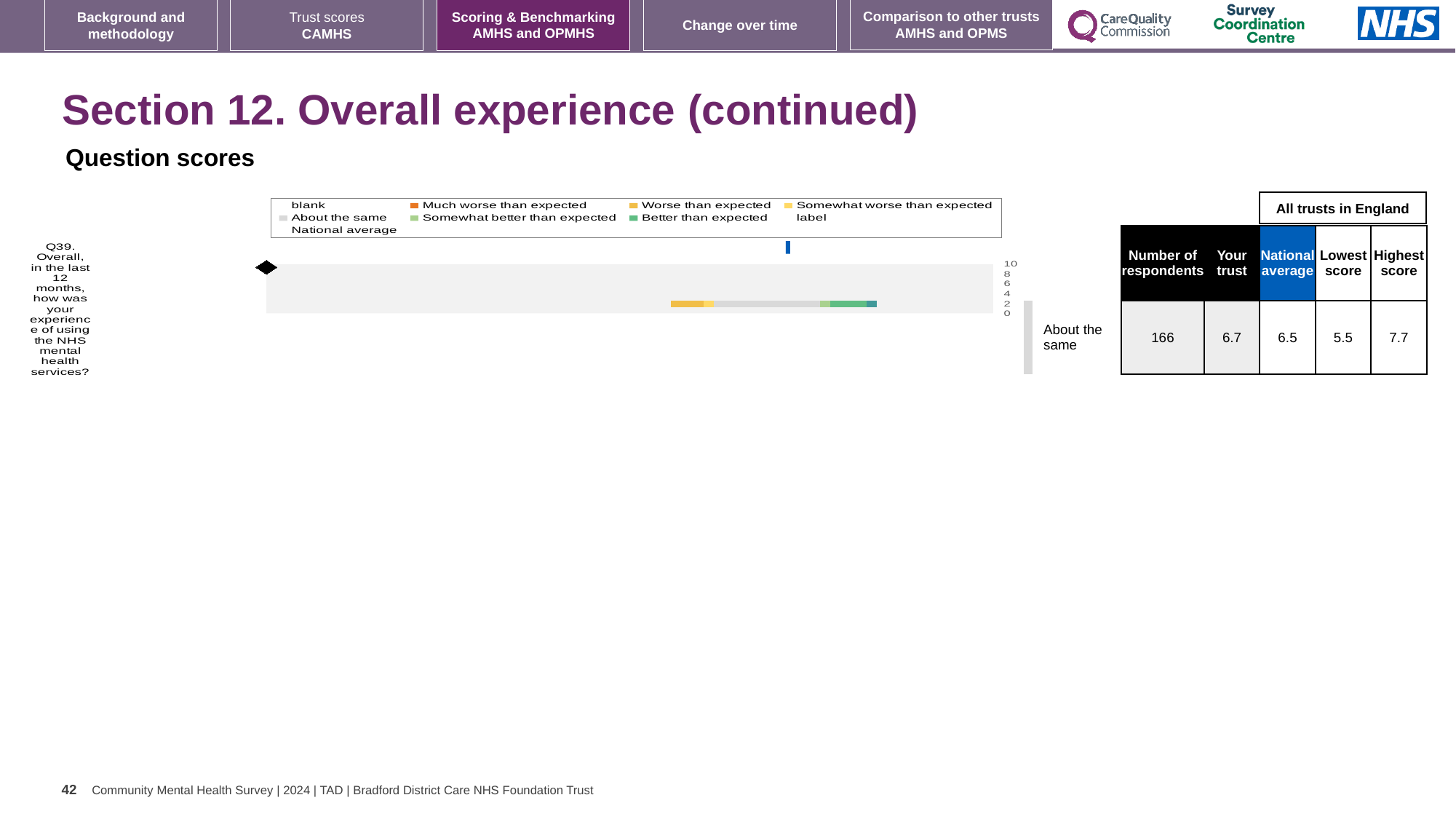
What is the difference between the highest and lowest trust scores for Q39? 2.2 Which is higher for Q39, the 'Your trust' score or the national average? Your trust How many respondents answered Q39? 166 What is the highest score among all trusts in England for Q39? 7.7 Which benchmark category is the trust's Q39 score placed in? About the same What kind of chart is used to show the Q39 question score? bar chart What is the lowest score among all trusts in England for Q39? 5.5 How many survey questions are plotted in the chart? 1 What is the national average score for Q39? 6.5 What is the difference between the 'Your trust' score and the national average for Q39? 0.2 What is the highest tick value shown on the chart's score axis? 10 What is the 'Your trust' score for Q39? 6.7